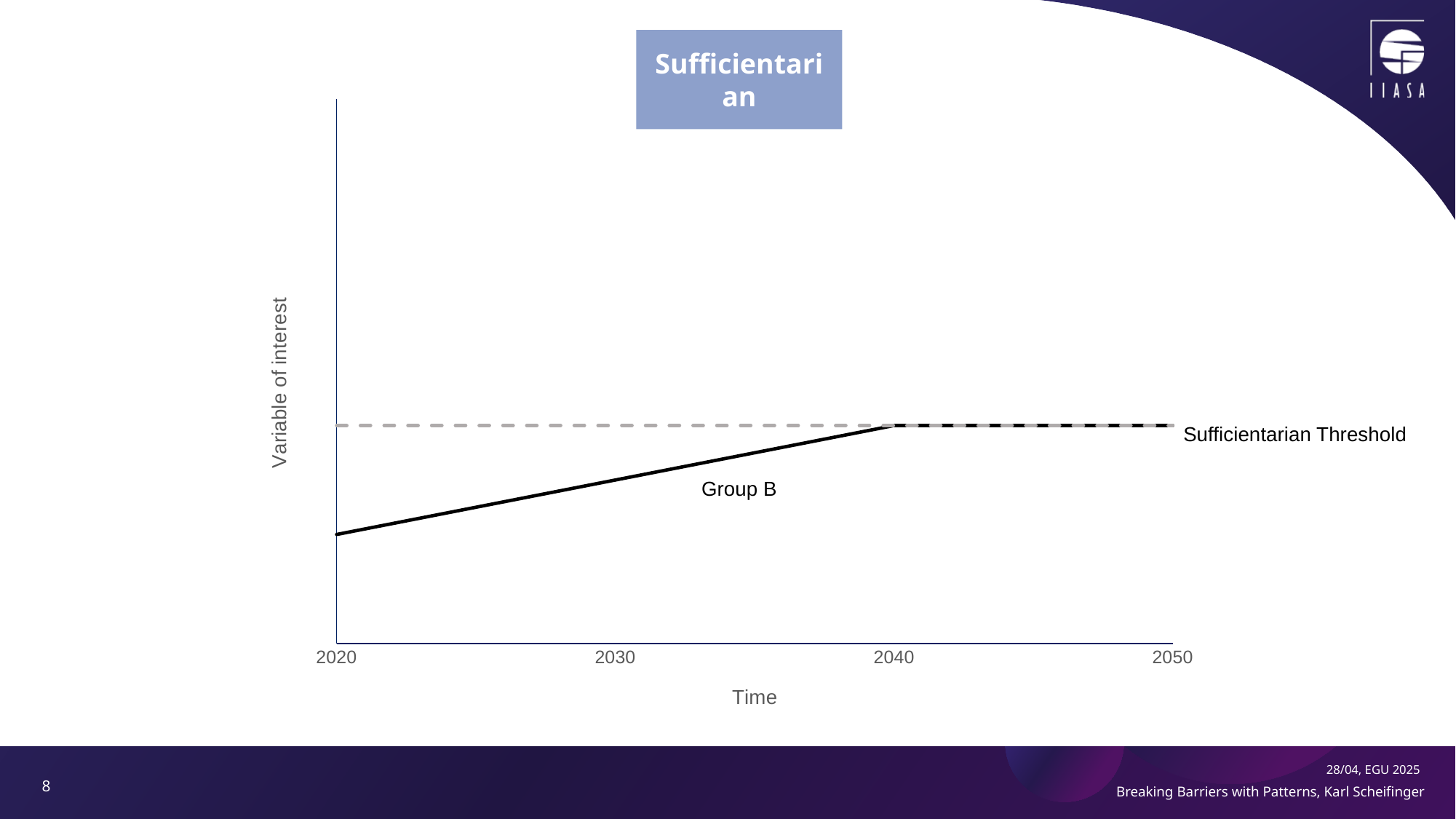
Does the Group B line rise or fall between 2020 and 2040? rise What is the last year label on the x axis? 2050 In 2020, is the Group B line above or below the Sufficientarian Threshold? below What is the first year label on the x axis? 2020 Does the Group B line rise, fall or stay flat between 2040 and 2050? stay flat In 2050, is the Group B line above, below or at the Sufficientarian Threshold? at Which is larger for Group B, the value in 2030 or the value in 2020? 2030 What kind of chart is shown on the slide? line chart What is the label of the y axis? Variable of interest In which year does the Group B line reach the Sufficientarian Threshold? 2040 What is the label of the dashed horizontal line? Sufficientarian Threshold How many year labels are shown on the x axis? 4